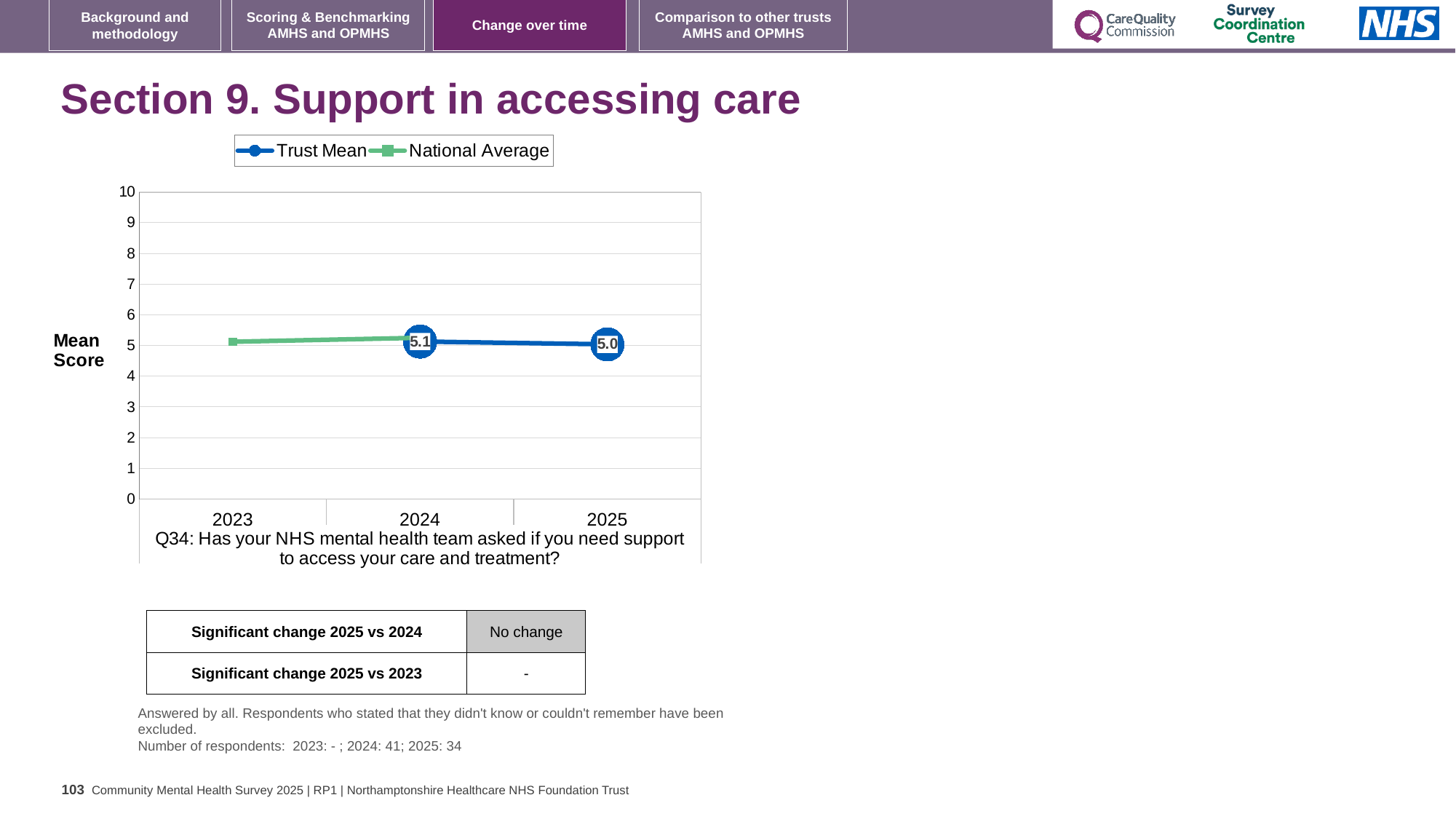
What is the Trust Mean score for 2024? 5.1 What are the two series named in the legend? Trust Mean and National Average How many years are shown on the x axis? 3 By how much did the Trust Mean change from 2024 to 2025? 0.1 Which year has the higher Trust Mean score, 2024 or 2025? 2024 What is the label on the y axis of the chart? Mean Score How many series does the legend list? 2 Does the Trust Mean rise or fall from 2024 to 2025? fall What kind of chart is shown on the slide? line chart Is the National Average value for 2023 greater or less than 4? greater Is the National Average value for 2023 greater or less than 6? less What is the Trust Mean score for 2025? 5.0